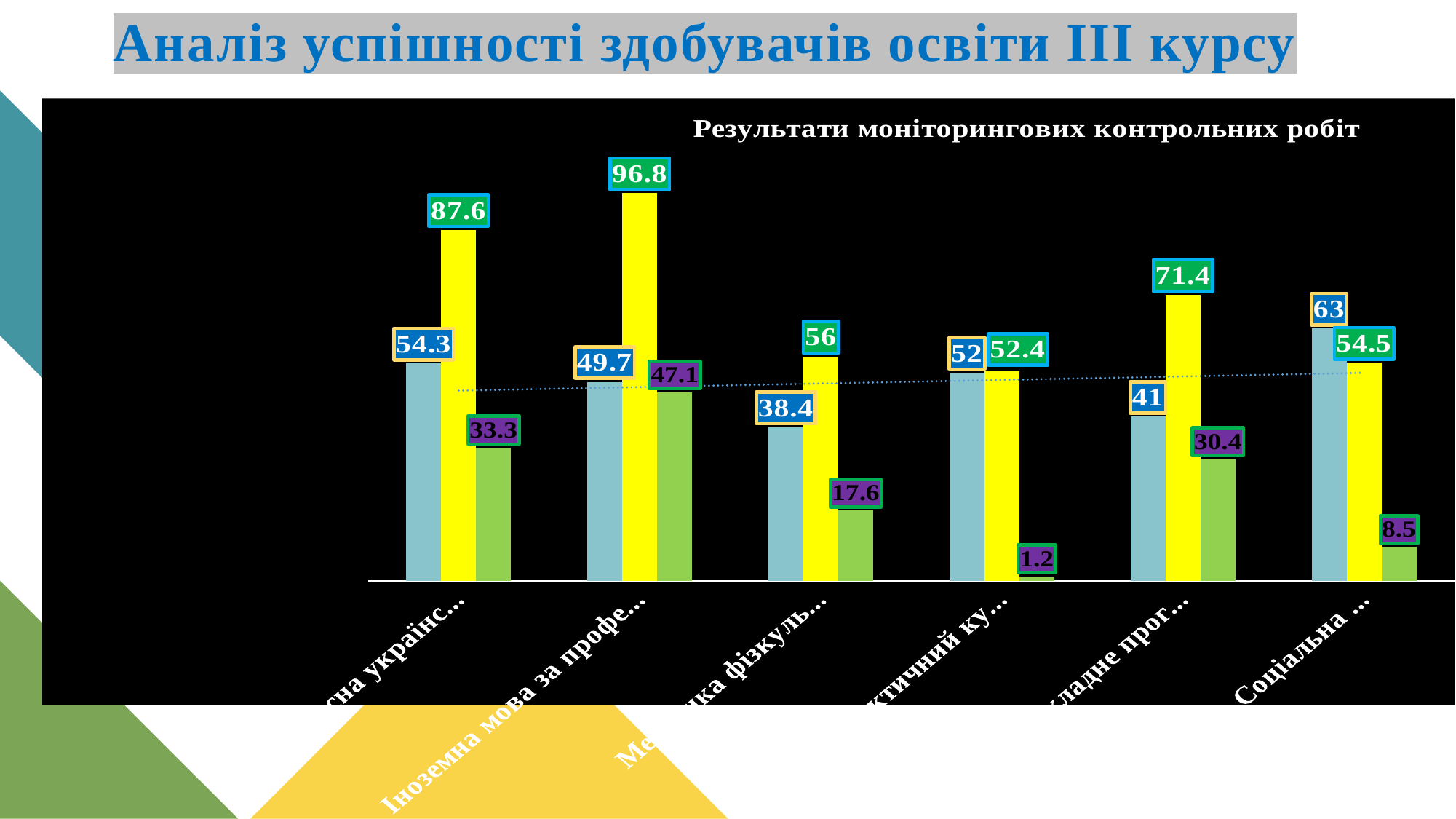
What is the value of the green bar in the fifth category group (label ending "кладне прог...")? 30.4 What is the value of the yellow bar in the last category group (label beginning "Соціальна")? 54.5 What is the value of the light blue bar in the first category group? 54.3 What is the highest value among the yellow bars in the chart? 96.8 What is the title of the chart? Результати моніторингових контрольних робіт What is the highest value among the light blue bars in the chart? 63 In the second category group (label beginning "Іноземна мова за профе"), what is the difference between the yellow bar and the light blue bar? 47.1 What is the lowest value among the green bars in the chart? 1.2 What type of chart is shown under the title "Результати моніторингових контрольних робіт"? bar chart In the last category group (label beginning "Соціальна"), which bar is larger: the light blue bar or the yellow bar? light blue How many category groups are plotted along the x axis of the chart? 6 How many bars are shown in each category group of the chart? 3